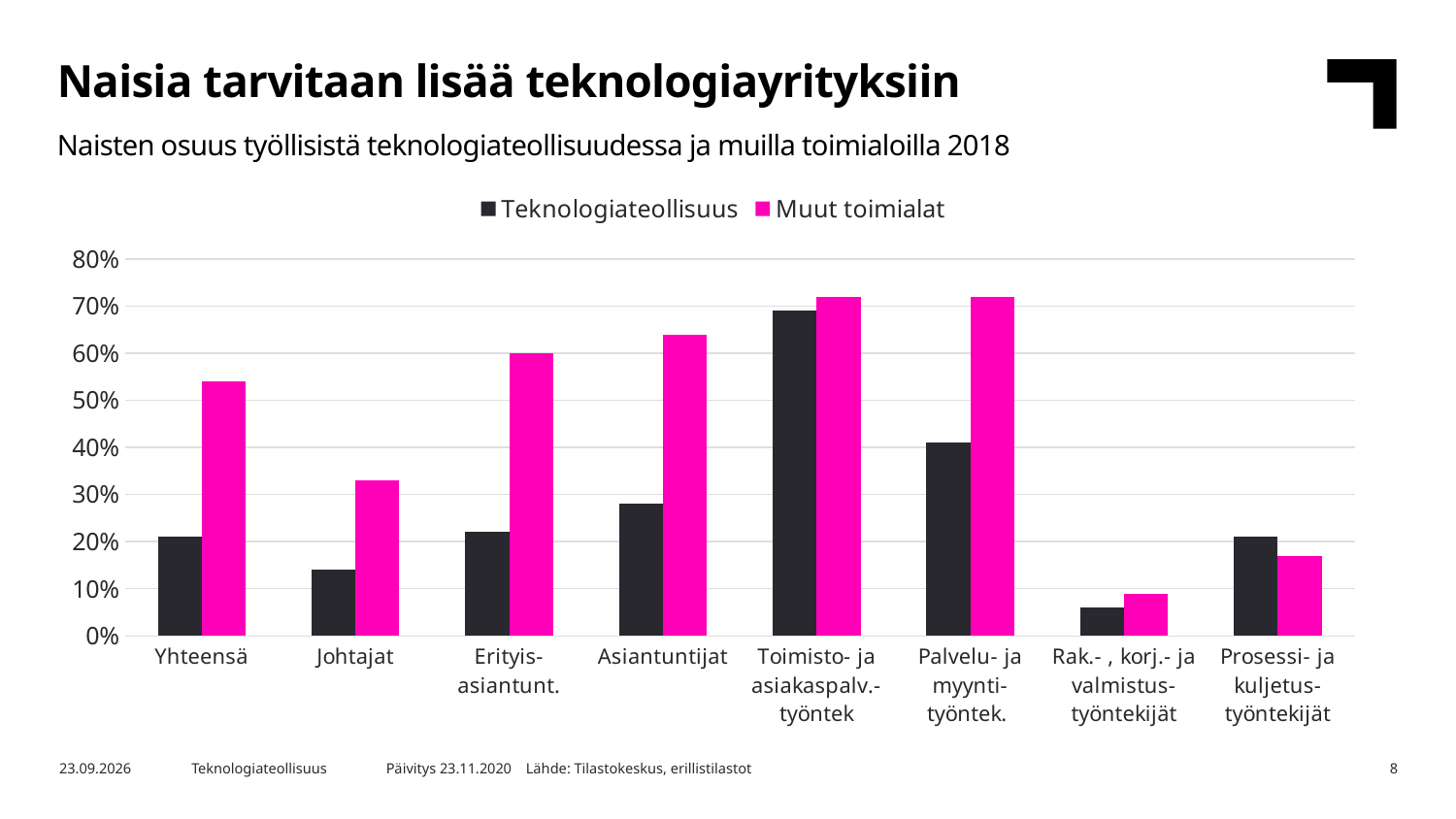
Which category has the lowest value for Muut toimialat? Rak.- , korj.- ja valmistus-työntekijät Is the Muut toimialat value for Yhteensä greater or less than 50%? greater How many series does the legend list? 2 Is the Teknologiateollisuus value for Johtajat greater or less than 20%? less What are the two series named in the legend? Teknologiateollisuus and Muut toimialat Is the Teknologiateollisuus value for Palvelu- ja myynti-työntek. greater or less than 50%? less How many categories are shown on the x axis? 8 Which category has the lowest value for Teknologiateollisuus? Rak.- , korj.- ja valmistus-työntekijät Which category has the highest value for Teknologiateollisuus? Toimisto- ja asiakaspalv.-työntek For Prosessi- ja kuljetus-työntekijät, which series has the larger value, Teknologiateollisuus or Muut toimialat? Teknologiateollisuus What kind of chart is shown on the slide? bar chart